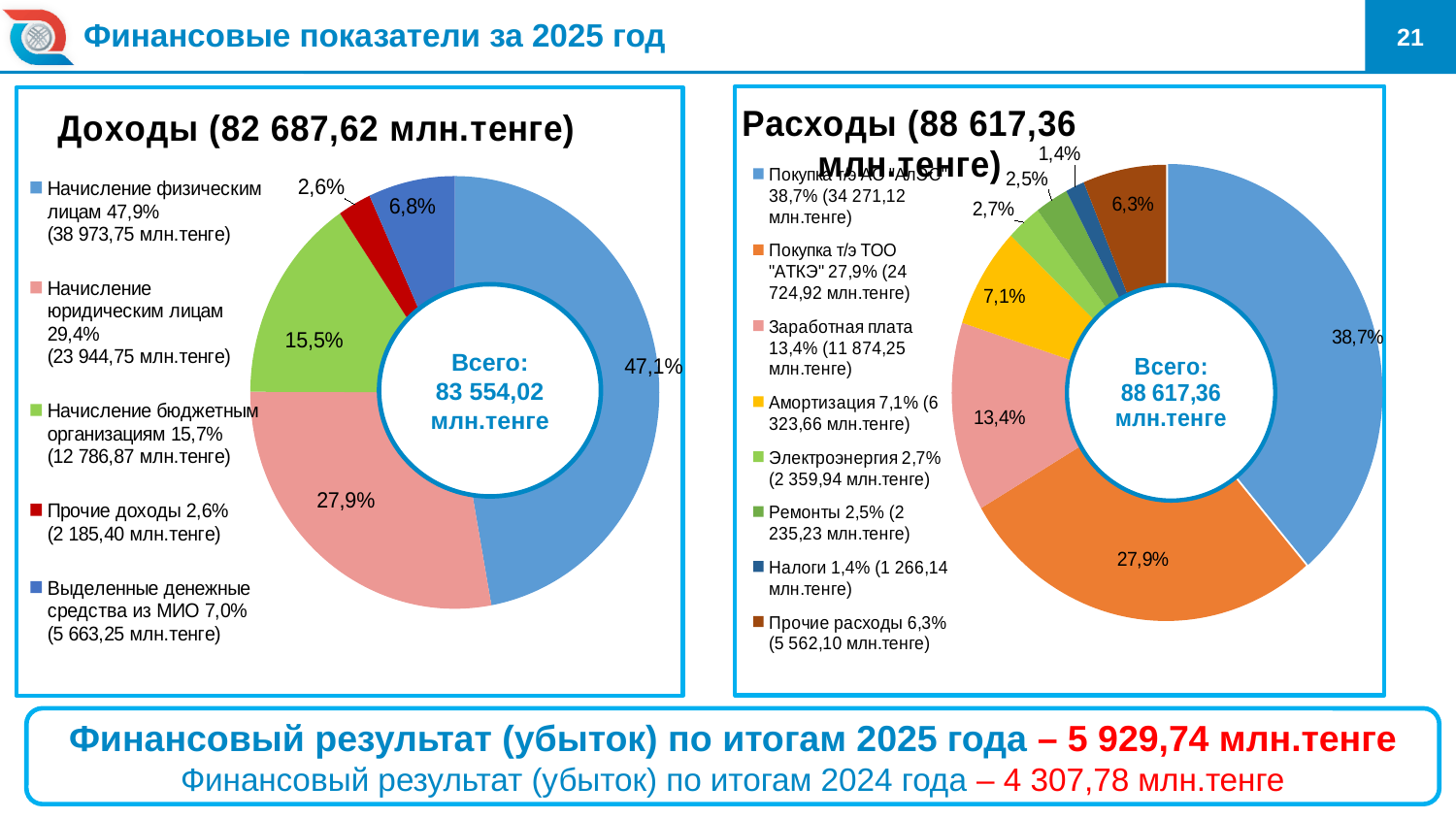
What total is written in the centre of the right chart "Расходы (88 617,36 млн.тенге)"? Всего: 88 617,36 млн.тенге What type of chart is used on the left chart titled "Доходы (82 687,62 млн.тенге)"? Doughnut (pie) chart On the left chart "Доходы (82 687,62 млн.тенге)", what amount in млн.тенге does the legend give for "Прочие доходы"? 2 185,40 млн.тенге On the right chart "Расходы (88 617,36 млн.тенге)", what percentage label is shown for the smallest slice? 1,4% On the right chart "Расходы (88 617,36 млн.тенге)", what percentage label is shown for the largest slice? 38,7% On the left chart "Доходы (82 687,62 млн.тенге)", what percentage label is shown on the largest slice? 47,1% On the right chart "Расходы (88 617,36 млн.тенге)", how many categories does the legend list? 8 On the left chart "Доходы (82 687,62 млн.тенге)", how many categories does the legend list? 5 On the right chart "Расходы (88 617,36 млн.тенге)", what is the difference in percentage points between "Покупка т/э АО "АлЭС"" (38,7%) and "Покупка т/э ТОО "АТКЭ"" (27,9%)? 10,8 percentage points On the right chart "Расходы (88 617,36 млн.тенге)", what amount in млн.тенге does the legend give for "Амортизация"? 6 323,66 млн.тенге On the right chart "Расходы (88 617,36 млн.тенге)", what is the percentage for "Заработная плата"? 13,4% On the right chart "Расходы (88 617,36 млн.тенге)", which is larger: "Электроэнергия" or "Ремонты"? Электроэнергия